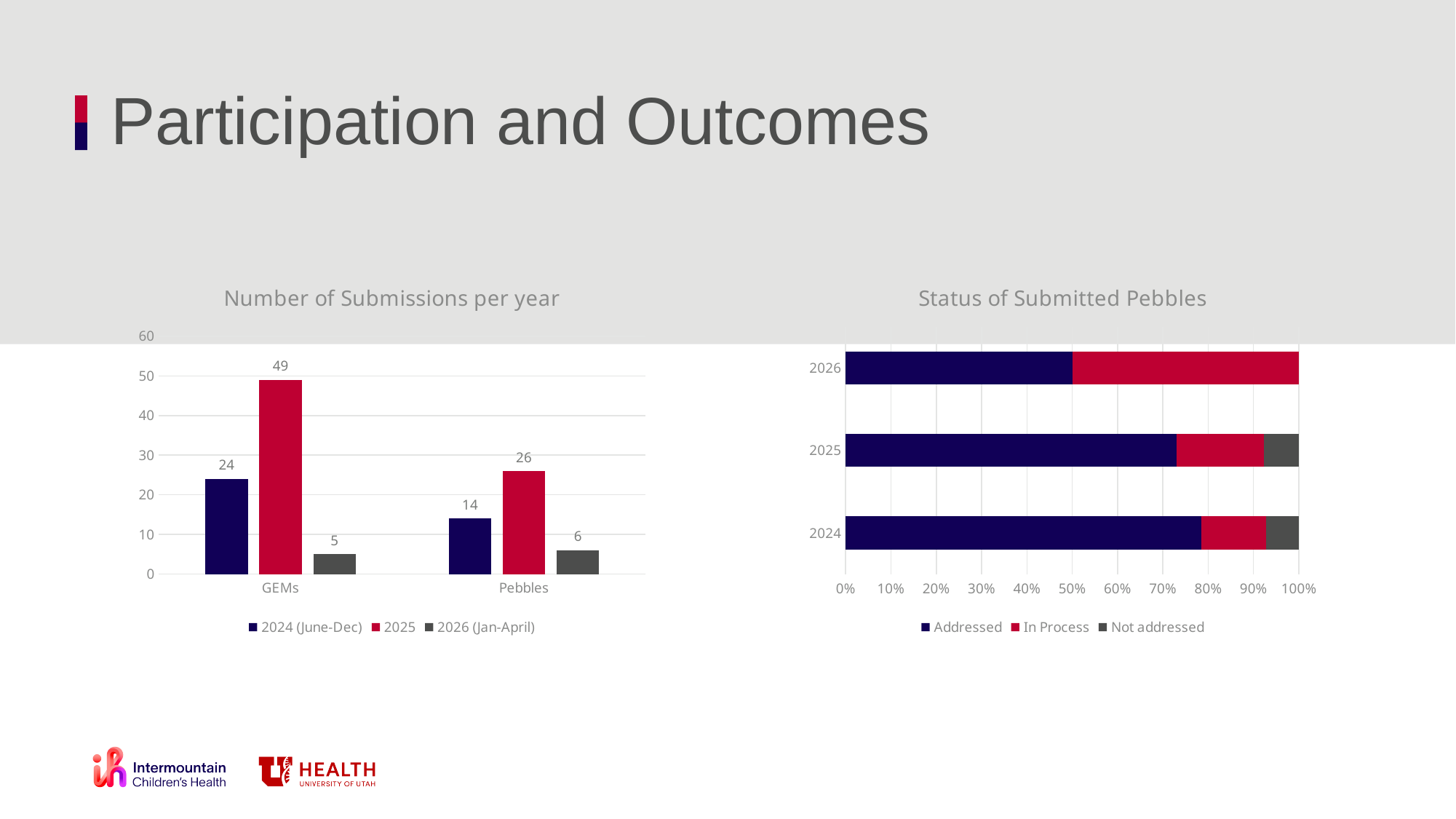
In the 'Number of Submissions per year' chart, how many GEMs were submitted in 2025? 49 In the 'Number of Submissions per year' chart, what is the difference between GEMs and Pebbles submissions in 2025? 23 In the 'Number of Submissions per year' chart, which series has the highest value for GEMs? 2025 In the 'Status of Submitted Pebbles' chart, is the Addressed share for 2025 greater or less than 70%? greater In the 'Number of Submissions per year' chart, which series has the lowest value for Pebbles? 2026 (Jan-April) In the 'Number of Submissions per year' chart, what is the value for Pebbles in 2024 (June-Dec)? 14 What kind of chart is 'Status of Submitted Pebbles'? Stacked bar chart How many series does the legend of the 'Number of Submissions per year' chart list? 3 In the 'Number of Submissions per year' chart, which is larger: GEMs in 2024 (June-Dec) or Pebbles in 2025? Pebbles in 2025 In the 'Number of Submissions per year' chart, what is the value for GEMs in 2026 (Jan-April)? 5 How many years are shown on the 'Status of Submitted Pebbles' chart? 3